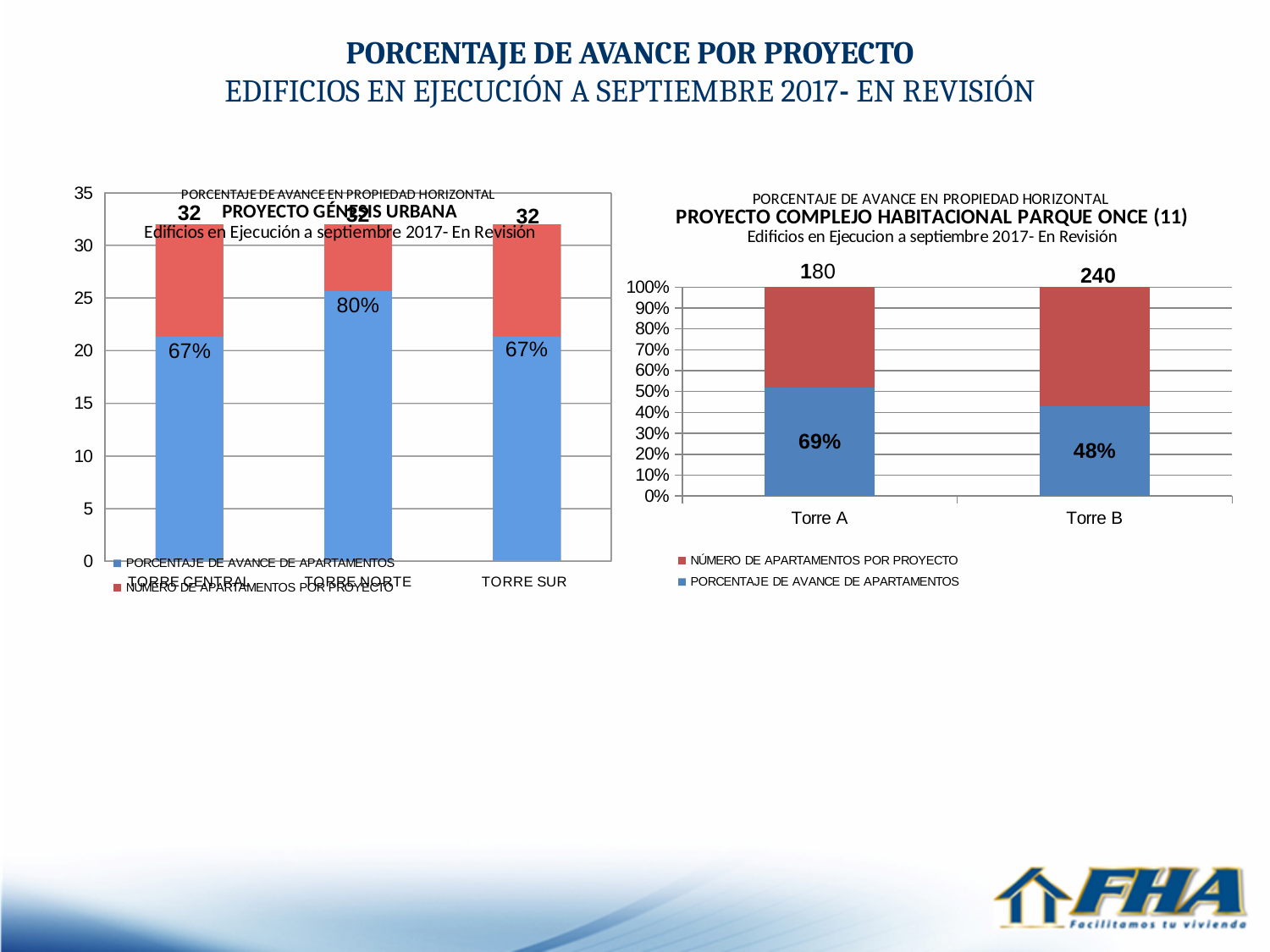
How many towers (categories) are shown in the left chart (PROYECTO GÉNESIS URBANA)? 3 What kind of chart is the left chart (PROYECTO GÉNESIS URBANA)? Stacked bar chart In the right chart (PROYECTO COMPLEJO HABITACIONAL PARQUE ONCE), what percentage of progress is shown for Torre A? 69% In the right chart (PROYECTO COMPLEJO HABITACIONAL PARQUE ONCE), what percentage of progress is shown for Torre B? 48% How many series does the legend of the right chart (PROYECTO COMPLEJO HABITACIONAL PARQUE ONCE) list? 2 In the right chart (PROYECTO COMPLEJO HABITACIONAL PARQUE ONCE), what is the difference between the numbers printed above Torre B and Torre A? 60 In the left chart (PROYECTO GÉNESIS URBANA), which tower has the highest percentage of progress? TORRE NORTE In the left chart (PROYECTO GÉNESIS URBANA), what percentage of progress is shown for TORRE NORTE? 80% In the right chart (PROYECTO COMPLEJO HABITACIONAL PARQUE ONCE), what is the difference between the progress percentages of Torre A and Torre B? 21% In the right chart (PROYECTO COMPLEJO HABITACIONAL PARQUE ONCE), what number is printed above the bar for Torre B? 240 In the right chart (PROYECTO COMPLEJO HABITACIONAL PARQUE ONCE), which tower has the higher percentage of progress, Torre A or Torre B? Torre A In the left chart (PROYECTO GÉNESIS URBANA), what number is printed above the bar for TORRE SUR? 32